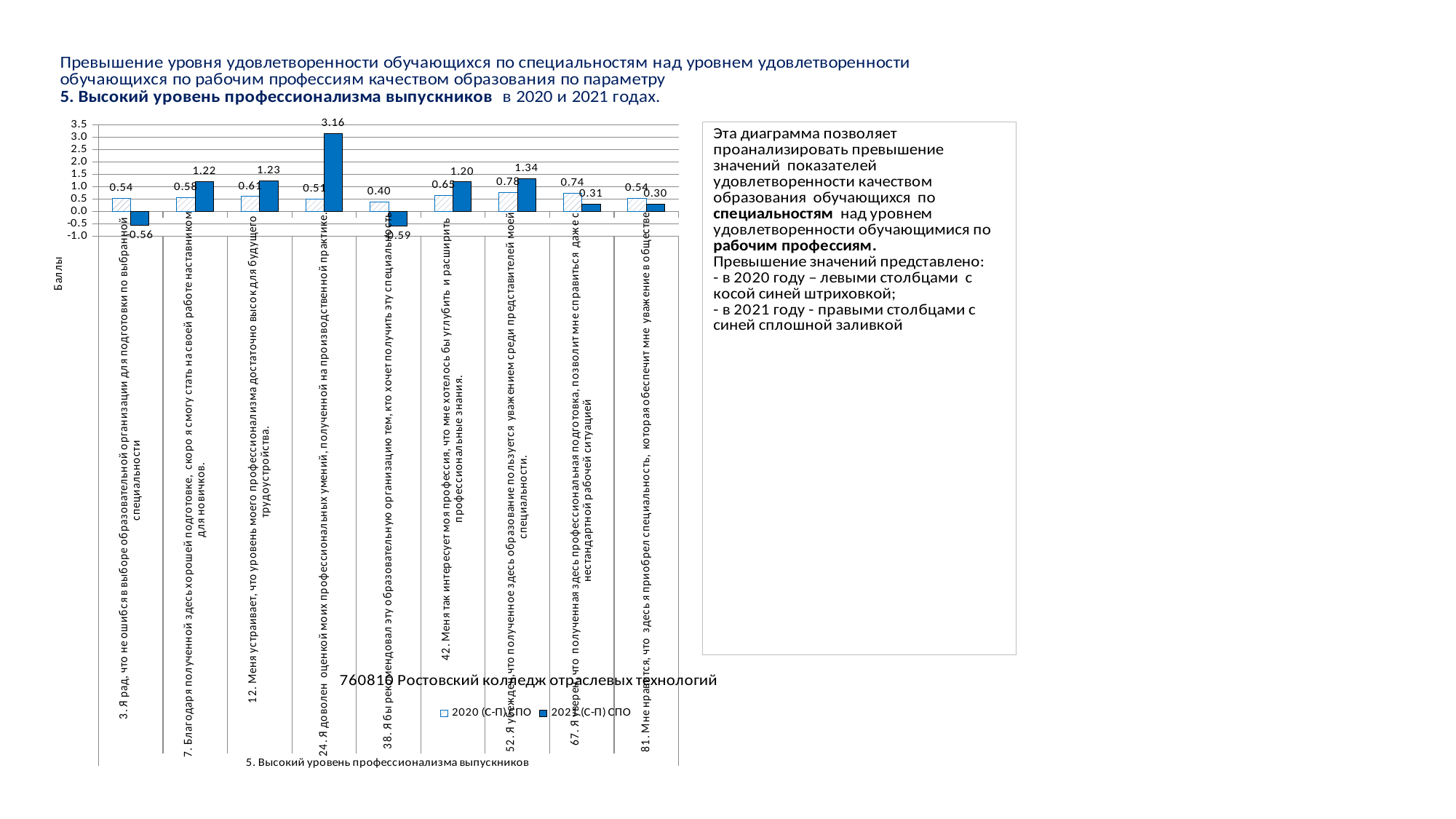
Which item has the lowest 2021 (С-П) СПО value? 38. Я бы рекомендовал эту образовательную организацию тем, кто хочет получить эту специальность For item 67 (Я уверен, что полученная здесь профессиональная подготовка позволит мне справиться даже с нестандартной рабочей ситуацией), which is larger: the 2020 or the 2021 value? 2020 How many items (categories) are shown on the x axis of the chart? 9 What type of chart is shown on the slide? Bar chart What is the 2020 (С-П) СПО value for item 52 (Я убежден, что полученное здесь образование пользуется уважением)? 0.78 Which item has the lowest 2020 (С-П) СПО value? 38. Я бы рекомендовал эту образовательную организацию тем, кто хочет получить эту специальность What is the 2021 (С-П) СПО value for item 24 (Я доволен оценкой моих профессиональных умений, полученной на производственной практике)? 3.16 What is the 2020 (С-П) СПО value for item 38 (Я бы рекомендовал эту образовательную организацию тем, кто хочет получить эту специальность)? 0.40 How many series does the chart legend list? 2 What is the 2021 (С-П) СПО value for item 3 (Я рад, что не ошибся в выборе образовательной организации)? -0.56 Which item has the highest 2021 (С-П) СПО value? 24. Я доволен оценкой моих профессиональных умений, полученной на производственной практике What is the difference between the 2021 and 2020 (С-П) СПО values for item 24? 2.65